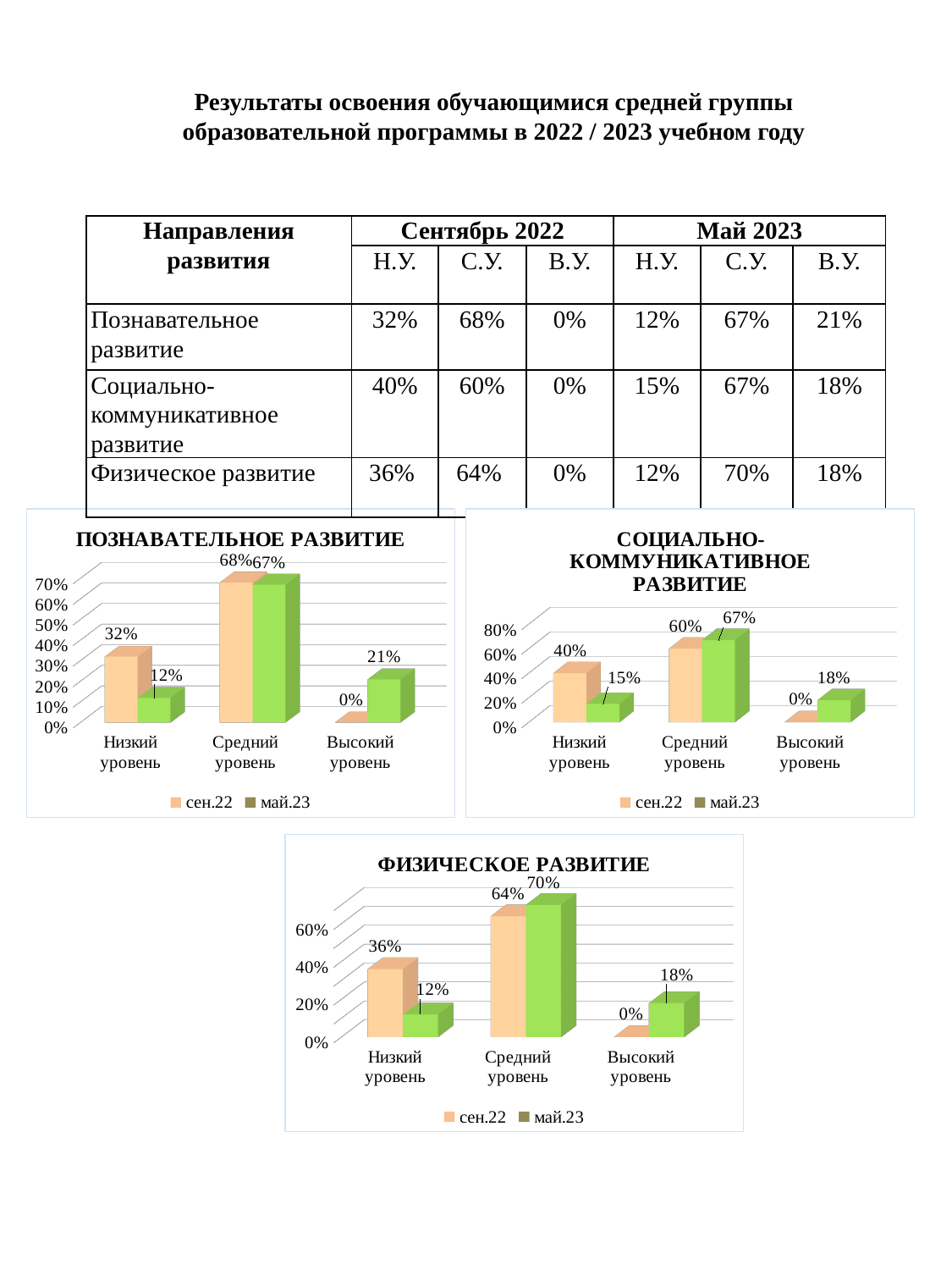
In the ПОЗНАВАТЕЛЬНОЕ РАЗВИТИЕ chart, what is the difference between the сен.22 and май.23 values for Низкий уровень? 20% In the СОЦИАЛЬНО-КОММУНИКАТИВНОЕ РАЗВИТИЕ chart, which is larger for Низкий уровень: сен.22 or май.23? сен.22 In the ФИЗИЧЕСКОЕ РАЗВИТИЕ chart, what is the value for Средний уровень in май.23? 70% In the ФИЗИЧЕСКОЕ РАЗВИТИЕ chart, what is the value for Высокий уровень in сен.22? 0% In the ПОЗНАВАТЕЛЬНОЕ РАЗВИТИЕ chart, what is the value for Низкий уровень in сен.22? 32% In the ПОЗНАВАТЕЛЬНОЕ РАЗВИТИЕ chart, what is the value for Высокий уровень in май.23? 21% In the СОЦИАЛЬНО-КОММУНИКАТИВНОЕ РАЗВИТИЕ chart, what is the value for Средний уровень in май.23? 67% How many categories are shown on the x axis of the ПОЗНАВАТЕЛЬНОЕ РАЗВИТИЕ chart? 3 How many series does the legend of the ФИЗИЧЕСКОЕ РАЗВИТИЕ chart list? 2 In the СОЦИАЛЬНО-КОММУНИКАТИВНОЕ РАЗВИТИЕ chart, which category has the highest сен.22 value? Средний уровень What type of chart is the СОЦИАЛЬНО-КОММУНИКАТИВНОЕ РАЗВИТИЕ chart? Bar chart In the ФИЗИЧЕСКОЕ РАЗВИТИЕ chart, what is the difference between the май.23 and сен.22 values for Средний уровень? 6%